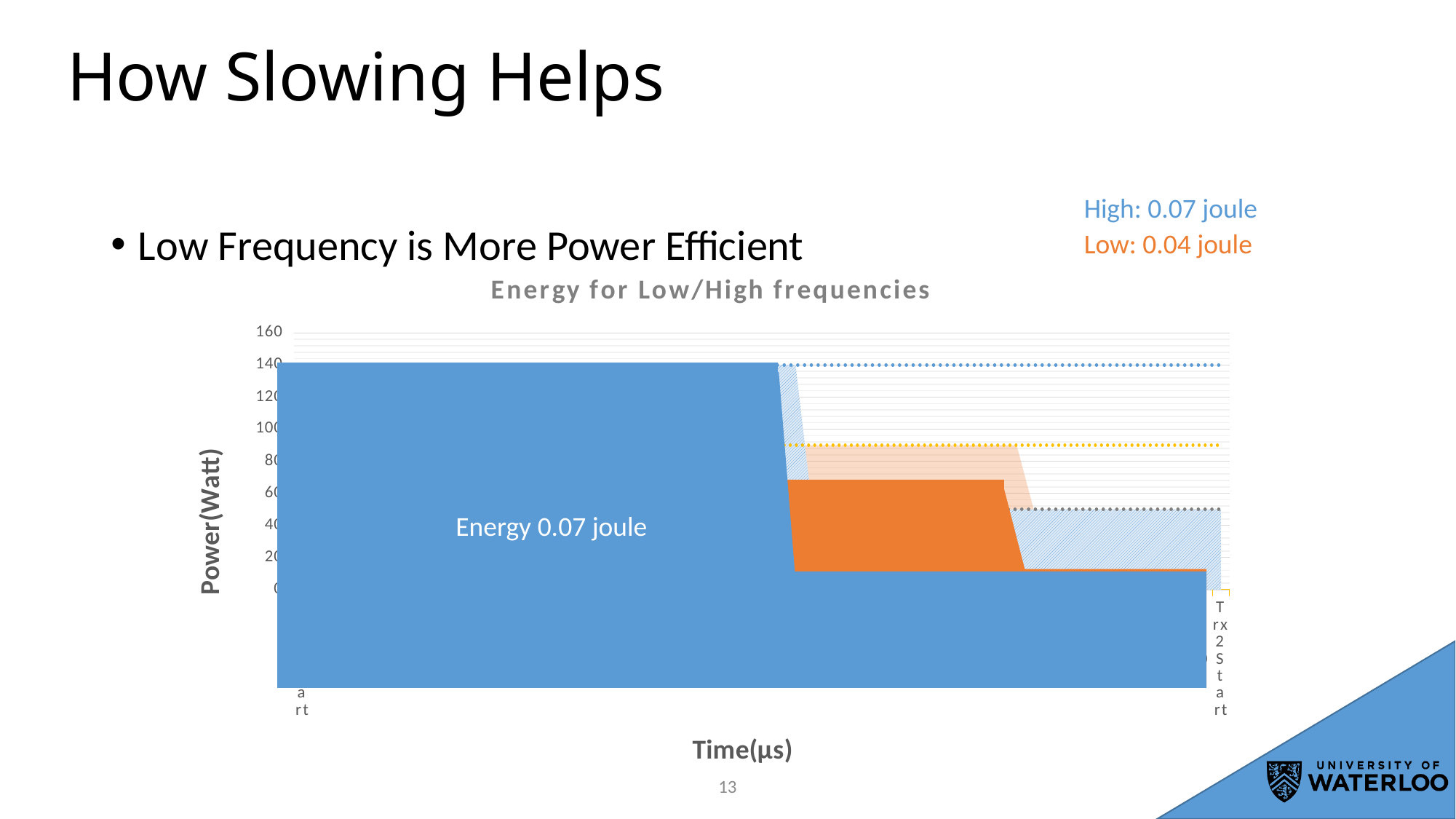
What energy value is given for the low frequency? 0.04 joule Does the power of the blue area rise or fall along the time axis? fall What energy value is given for the high frequency? 0.07 joule Is the initial power level of the blue (high frequency) area greater or less than 100 Watt? greater Which frequency uses more energy, high or low? High What is the highest value shown on the Power(Watt) axis? 160 What is the label of the horizontal axis of the chart? Time(µs) What is the difference between the high-frequency energy and the low-frequency energy? 0.03 joule What is the title of the chart? Energy for Low/High frequencies What kind of chart is shown on the slide? area chart